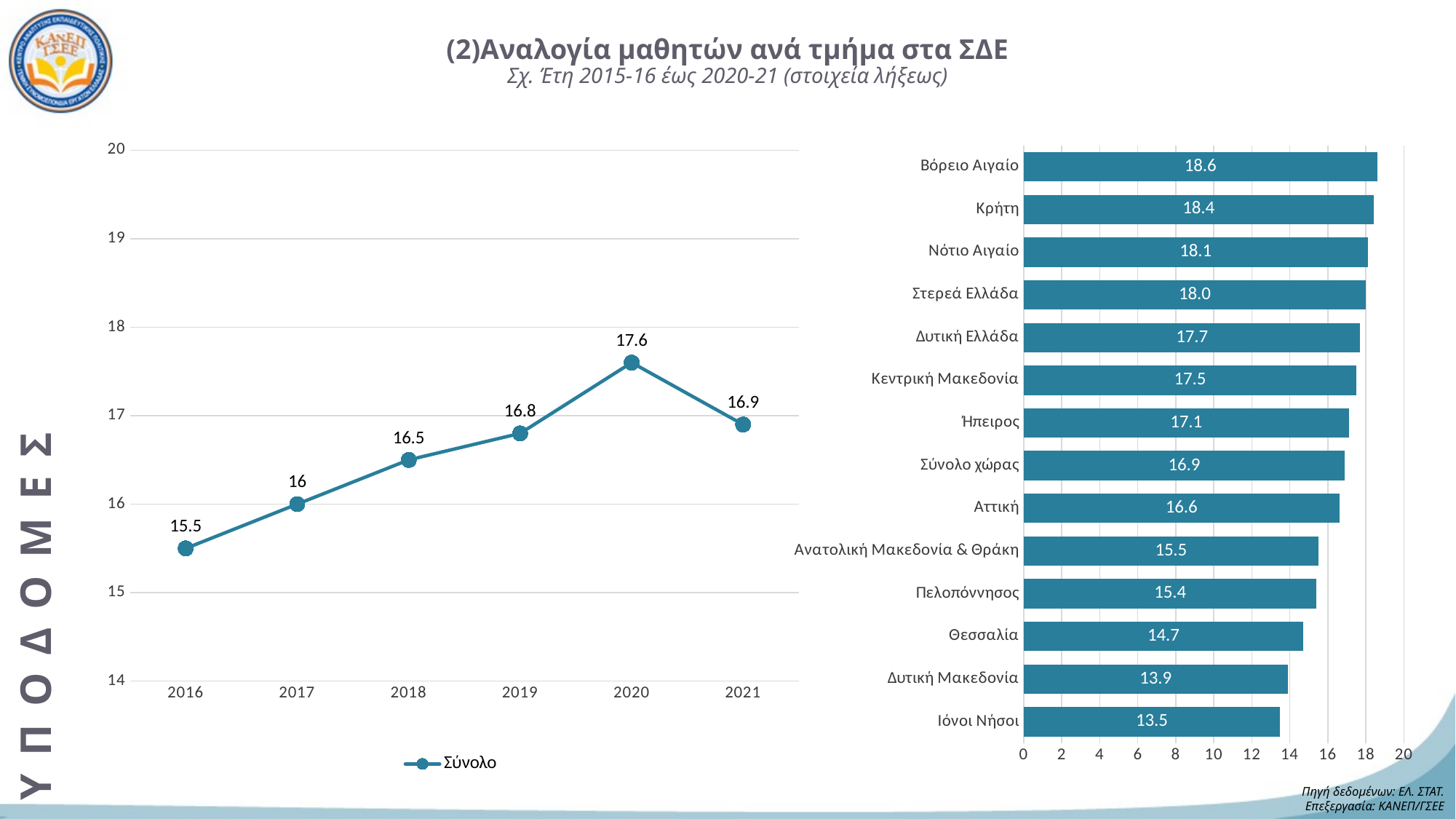
In the line chart on the left, how many data points are plotted? 6 In the line chart on the left, what is the difference between the values for 2020 and 2021? 0.7 In the bar chart on the right, which region has the highest value? Βόρειο Αιγαίο In the bar chart on the right, which region has the lowest value? Ιόνοι Νήσοι In the line chart on the left, what is the name of the series shown in the legend? Σύνολο In the line chart on the left, which year has the lowest value? 2016 In the line chart on the left, what is the value for 2016? 15.5 In the bar chart on the right, what is the value for Κρήτη? 18.4 In the line chart on the left, which year has the highest value? 2020 In the bar chart on the right, which is larger: the value for Αττική or the value for Θεσσαλία? Αττική In the line chart on the left, what is the value for 2020? 17.6 In the bar chart on the right, how many bars are shown? 14